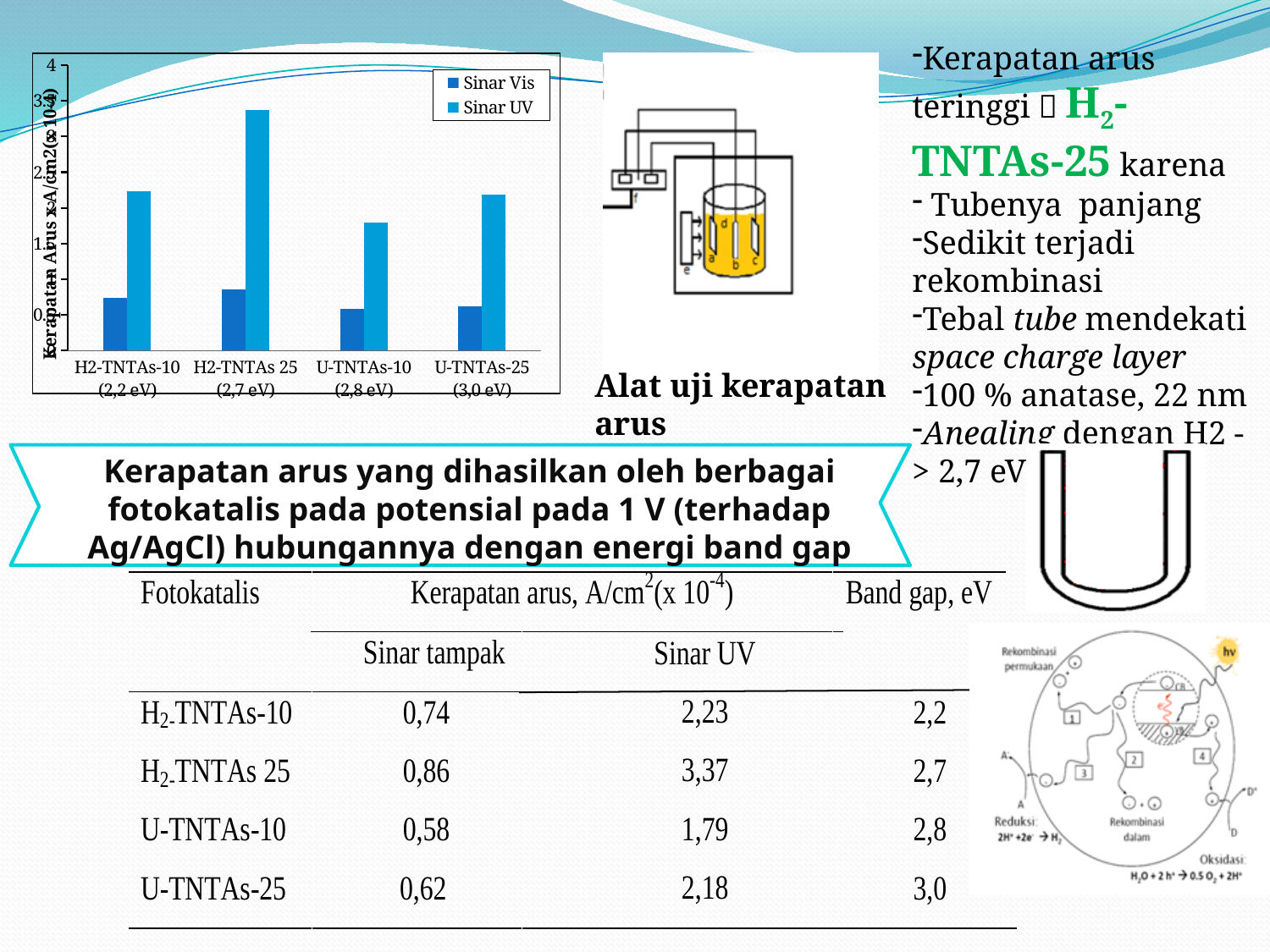
Is the Sinar UV value for U-TNTAs-10 greater or less than 2? less According to the table on the slide, what is the Sinar UV current density for H2-TNTAs 25? 3,37 Which category has the highest Sinar Vis bar in the chart? H2-TNTAs 25 (2,7 eV) How many photocatalyst categories are shown on the x axis of the chart? 4 What are the two series named in the chart legend? Sinar Vis and Sinar UV How many series does the chart legend list? 2 Is the Sinar UV value for H2-TNTAs 25 greater or less than 3? greater Is the Sinar Vis value for U-TNTAs-10 greater or less than 0.5? greater Which category has the lowest Sinar UV bar in the chart? U-TNTAs-10 (2,8 eV) For U-TNTAs-25, which series has the larger bar, Sinar Vis or Sinar UV? Sinar UV What kind of chart is shown on the slide? bar chart Which category has the highest Sinar UV bar in the chart? H2-TNTAs 25 (2,7 eV)